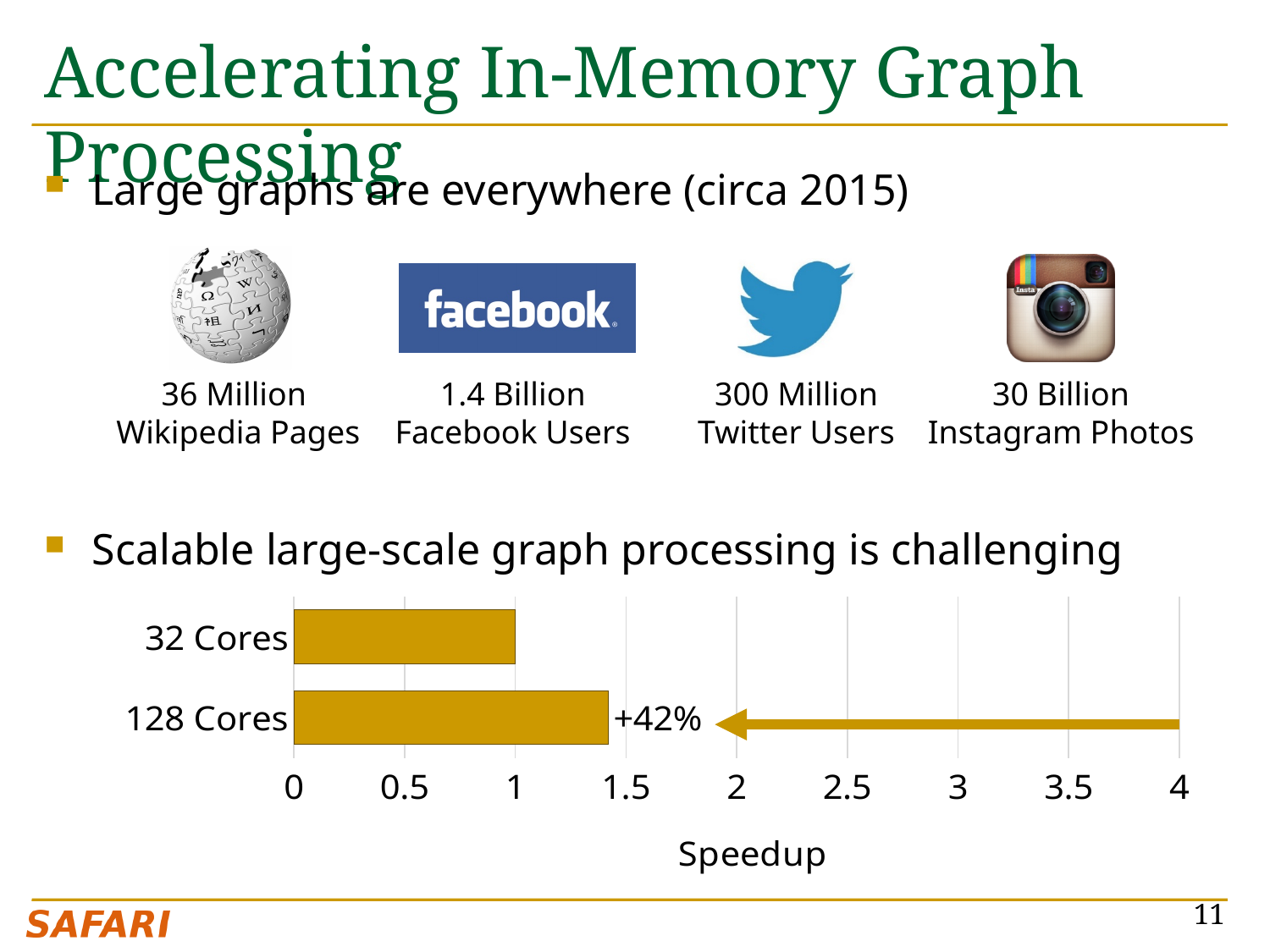
Which has a larger speedup, 32 Cores or 128 Cores? 128 Cores Is the speedup for 128 Cores greater or less than 1? greater What kind of chart is shown at the bottom of the slide? bar chart What is the label of the x axis in the bar chart? Speedup How many categories does the bar chart show? 2 Is the speedup for 128 Cores greater or less than 1.5? less Which category has the highest speedup in the bar chart? 128 Cores What is the speedup value for 32 Cores in the bar chart? 1 What is the maximum value shown on the x axis of the bar chart? 4 What annotation is printed next to the 128 Cores bar? +42% Which category has the lowest speedup in the bar chart? 32 Cores